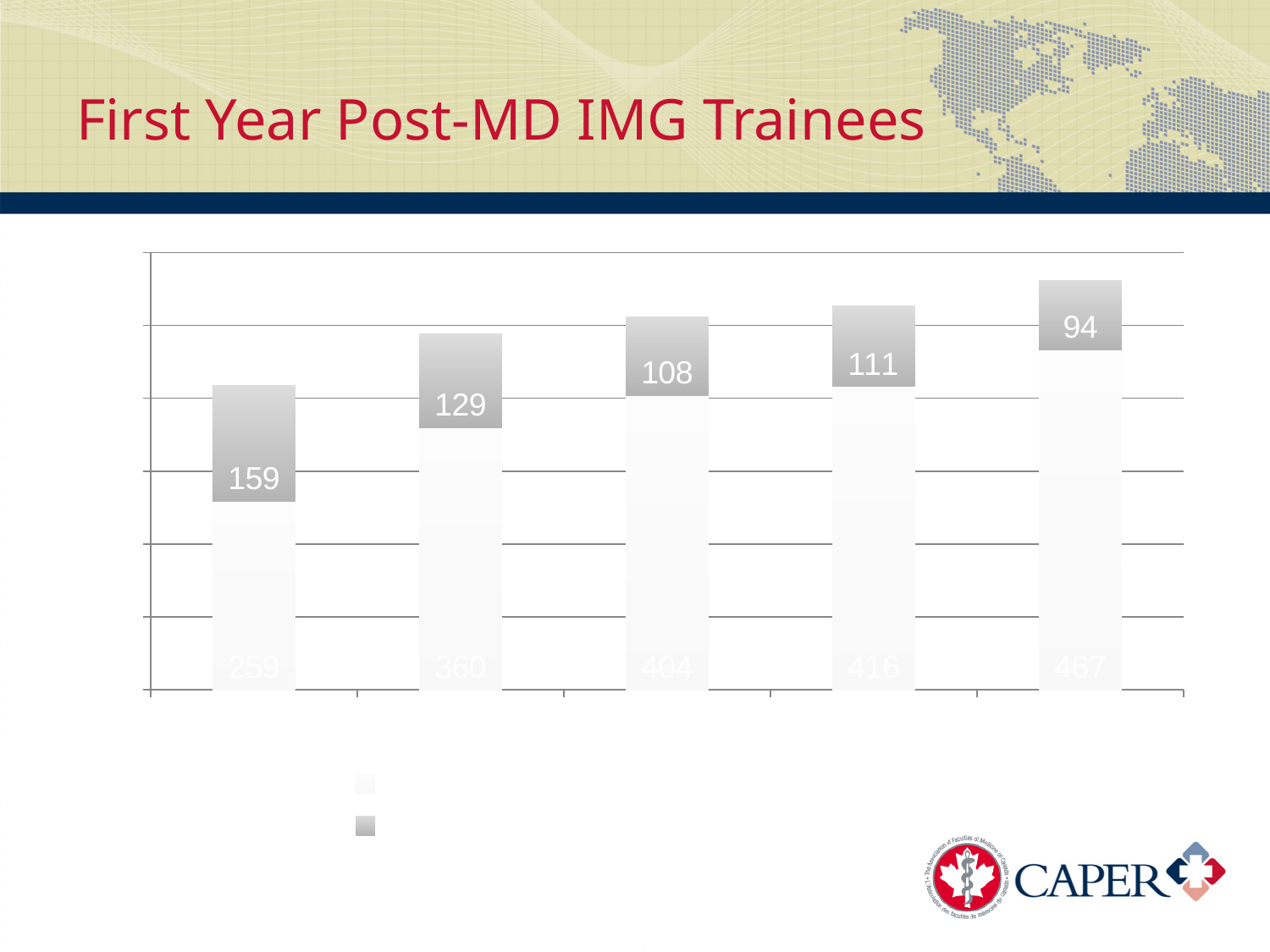
What is the title of the slide? First Year Post-MD IMG Trainees What is the value of the lower (lighter) segment of the fifth bar from the left? 467 What is the value of the upper (darker) segment of the third bar from the left? 108 Which is larger: the upper segment of the third bar (108) or the upper segment of the fourth bar (111)? The fourth bar (111) What is the total of the fifth bar from the left (467 + 94)? 561 What is the difference between the upper segment of the first bar (159) and the upper segment of the fifth bar (94)? 65 Which bar has the largest upper (darker) segment? The first bar from the left (159) What kind of chart is shown on the slide? Stacked bar chart How many series does the legend list? 2 What is the value of the upper (darker) segment of the first bar from the left? 159 How many bars are plotted in the chart? 5 Which bar has the smallest upper (darker) segment? The fifth bar from the left (94)